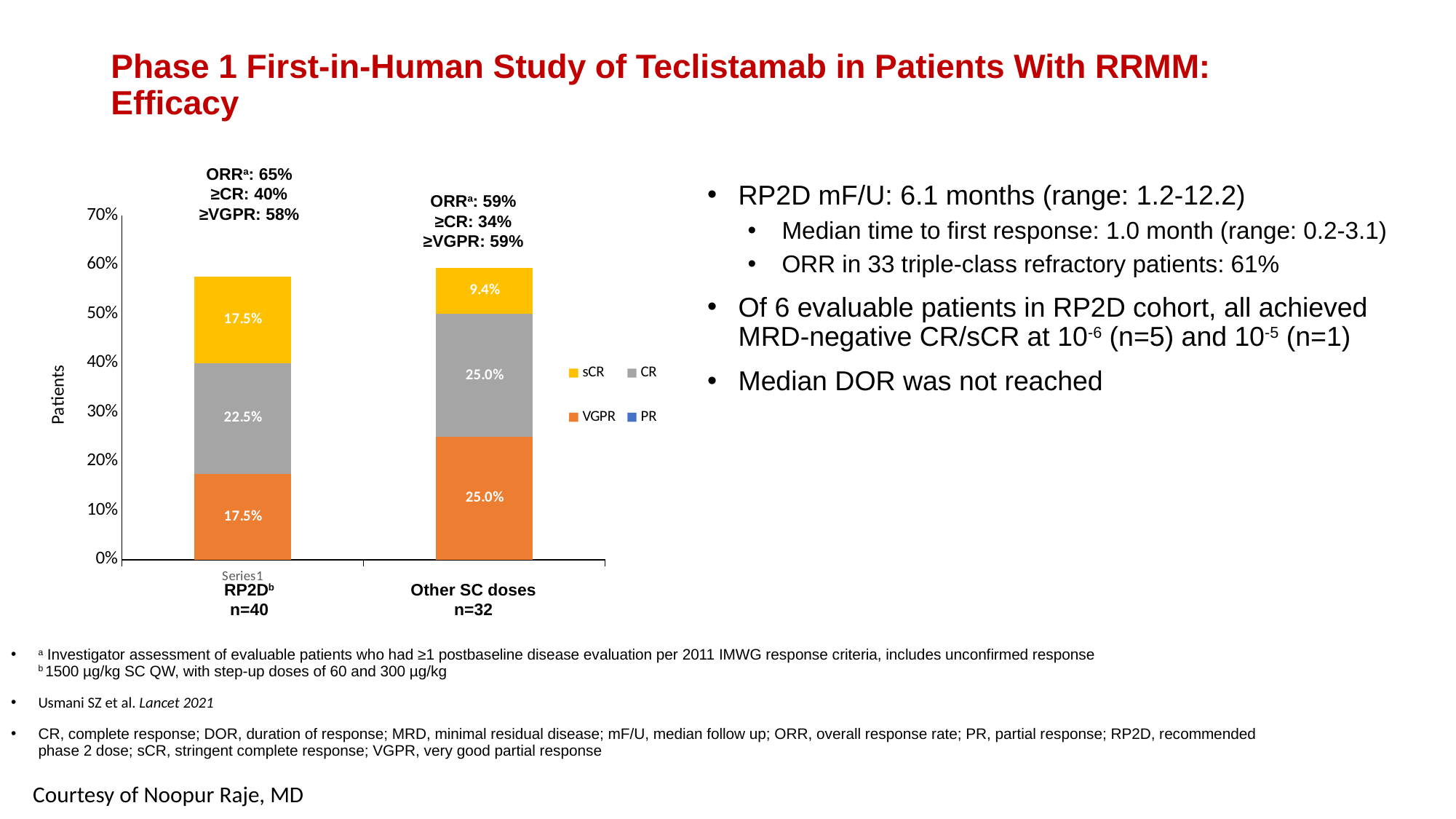
Which group has the larger sCR value, RP2D or Other SC doses? RP2D What kind of chart is shown on the slide? Stacked bar chart What is the sCR value for the Other SC doses group? 9.4% What is the sCR value for the RP2D group? 17.5% What is the difference between the CR value for Other SC doses and the CR value for RP2D? 2.5 percentage points What is the label on the y axis of the chart? Patients What is the total of the labelled segments in the RP2D stacked bar? 57.5% How many series does the chart legend list? 4 How many dose groups (categories) are plotted on the x axis of the chart? 2 What is the total of the labelled segments in the Other SC doses stacked bar? 59.4% What is the CR value for the Other SC doses group? 25.0% What is the VGPR value for the RP2D group? 17.5%